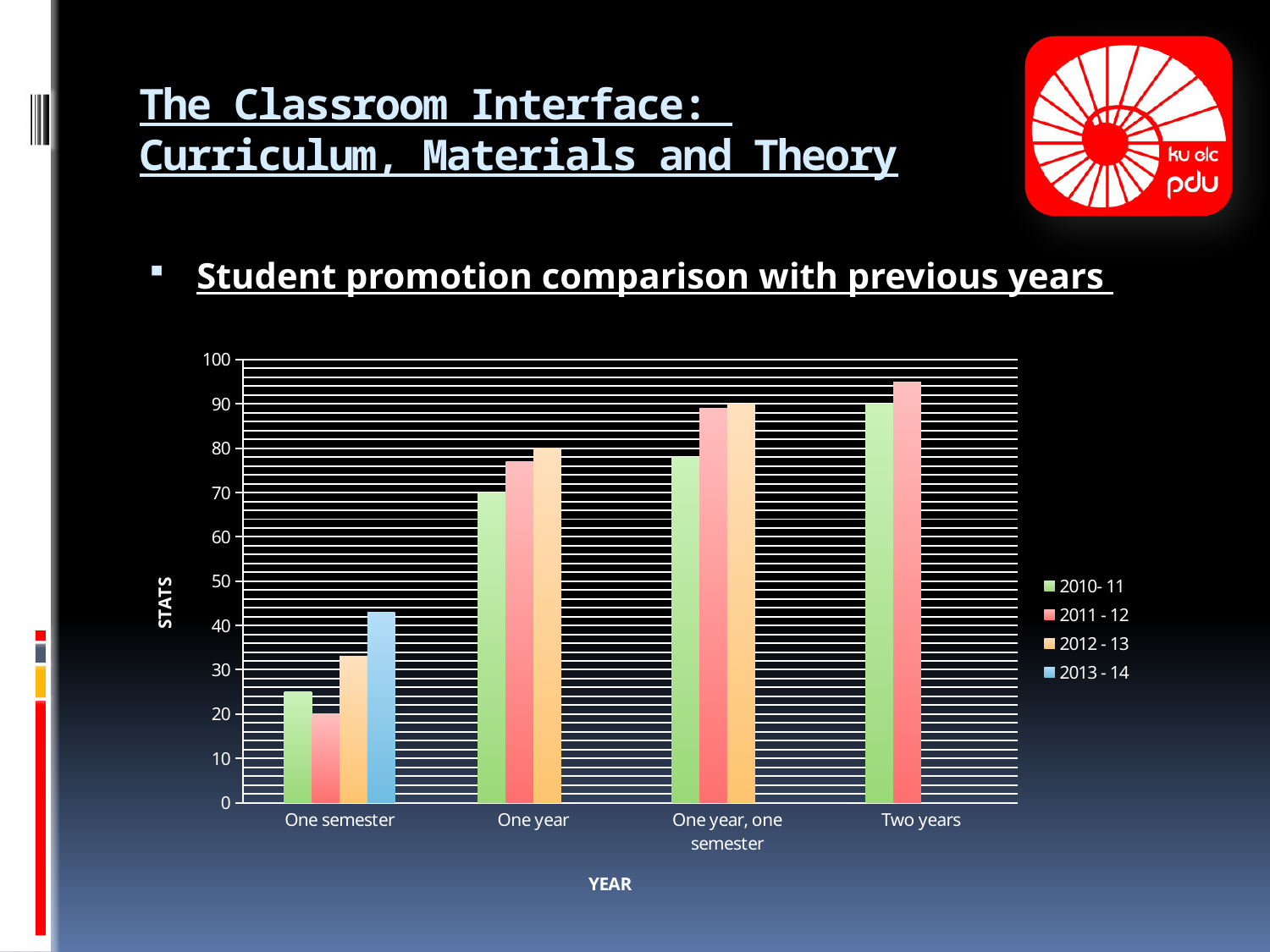
What kind of chart is shown on the slide? bar chart Is the value for 2011 - 12 in the Two years category greater or less than 90? greater Which series has the highest value in the One semester category? 2013 - 14 Do the values for the 2010- 11 series rise or fall from One semester to Two years along the x axis? rise Is the value for 2013 - 14 in the One semester category greater or less than 30? greater What is the label on the vertical axis of the chart? STATS In the Two years category, which is larger: the 2010- 11 value or the 2011 - 12 value? 2011 - 12 Is the value for 2011 - 12 in the One year category greater or less than 70? greater How many categories are shown along the x axis of the chart? 4 How many series does the chart's legend list? 4 Which series has the lowest value in the One semester category? 2011 - 12